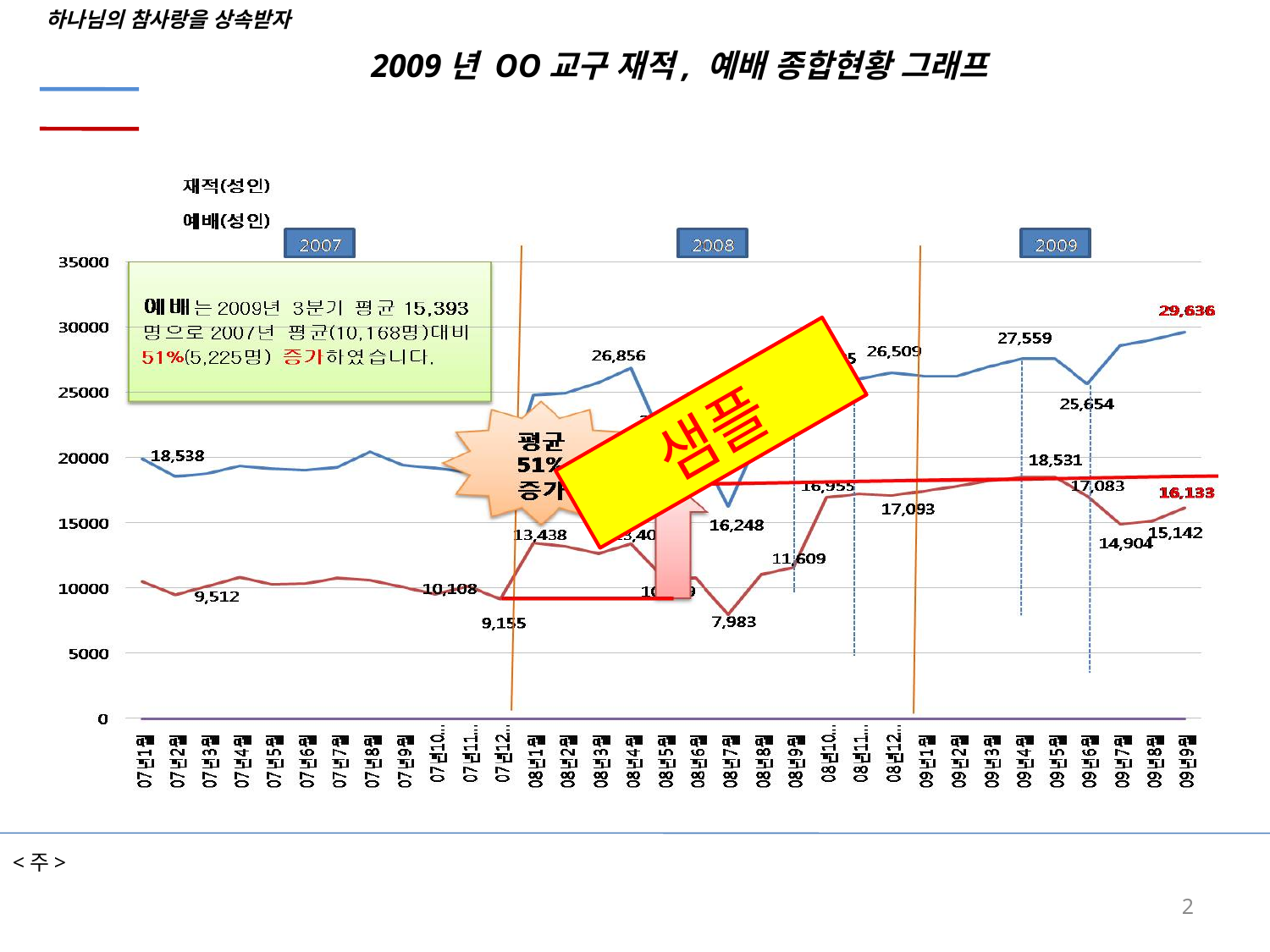
Is the value of 재적(성인) at 09년9월 greater or less than 25000? greater What kind of chart is shown on the slide? line chart What is the difference between the 재적(성인) values at 09년9월 (29,636) and 09년6월 (25,654)? 3,982 What is the value of 예배(성인) at 09년9월? 16,133 What is the lowest labelled value of the 예배(성인) series? 7,983 How many series does the chart's legend list? 2 At 09년9월, which series has the larger value, 재적(성인) or 예배(성인)? 재적(성인) What is the value of 재적(성인) at 09년9월? 29,636 What is the difference between 재적(성인) and 예배(성인) at 09년9월? 13,503 What is the title of the chart on the slide? 2009 년 OO 교구 재적, 예배 종합현황 그래프 Does the 재적(성인) series rise or fall from 09년6월 to 09년9월? rise